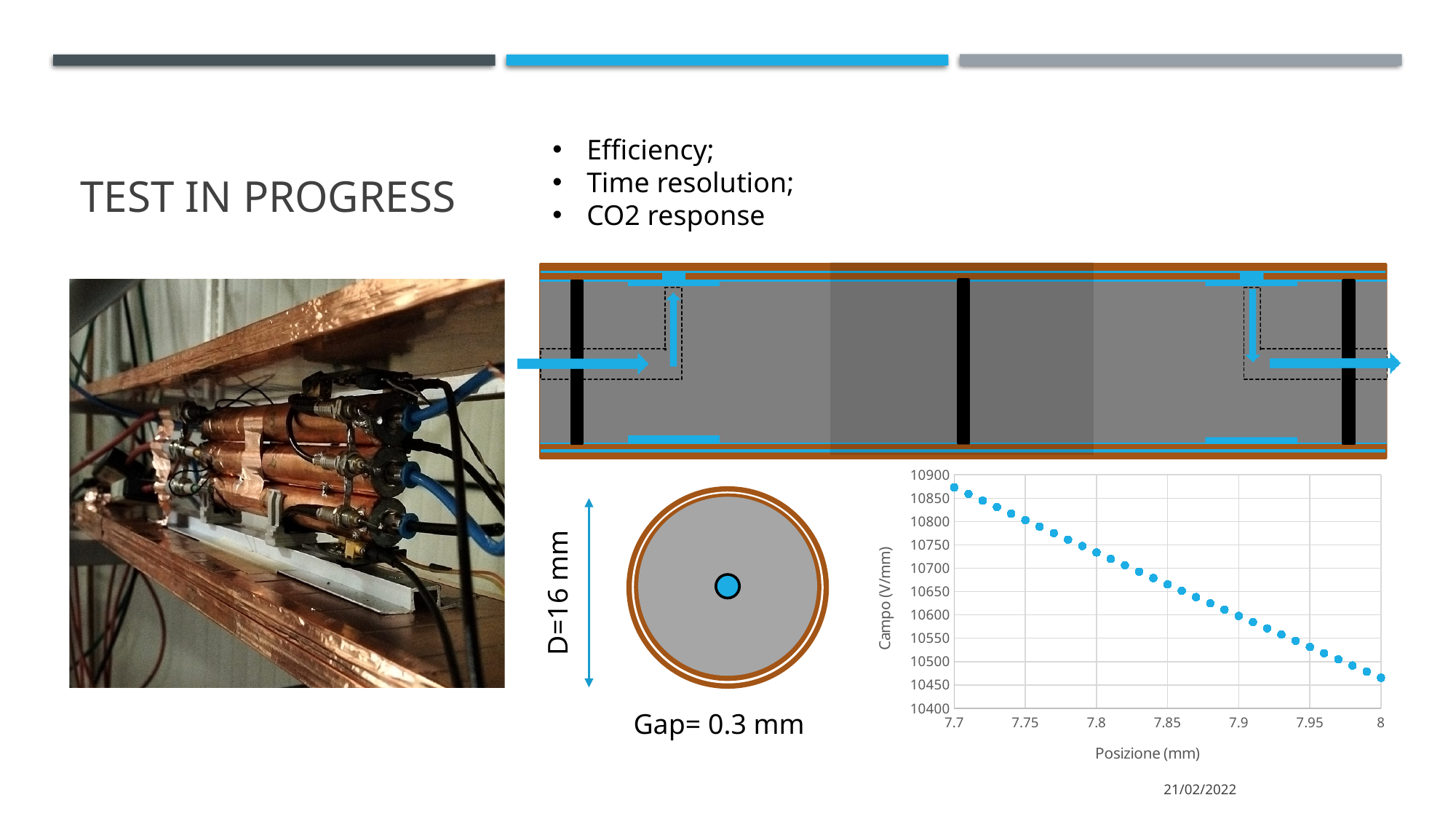
Is the value of Campo at Posizione 8 mm greater or less than 10500? less Is the value of Campo at Posizione 7.7 mm greater or less than 10850? greater Is the value of Campo at Posizione 7.85 mm greater or less than 10700? less What kind of chart is shown on the slide? scatter chart At which Posizione value is Campo highest? 7.7 At which Posizione value is Campo lowest? 8 What is the label of the x axis of the chart? Posizione (mm) Do the values of Campo (V/mm) rise or fall as Posizione (mm) increases from 7.7 to 8? fall What is the label of the y axis of the chart? Campo (V/mm) Which has the larger Campo value: Posizione 7.7 mm or Posizione 8 mm? 7.7 mm